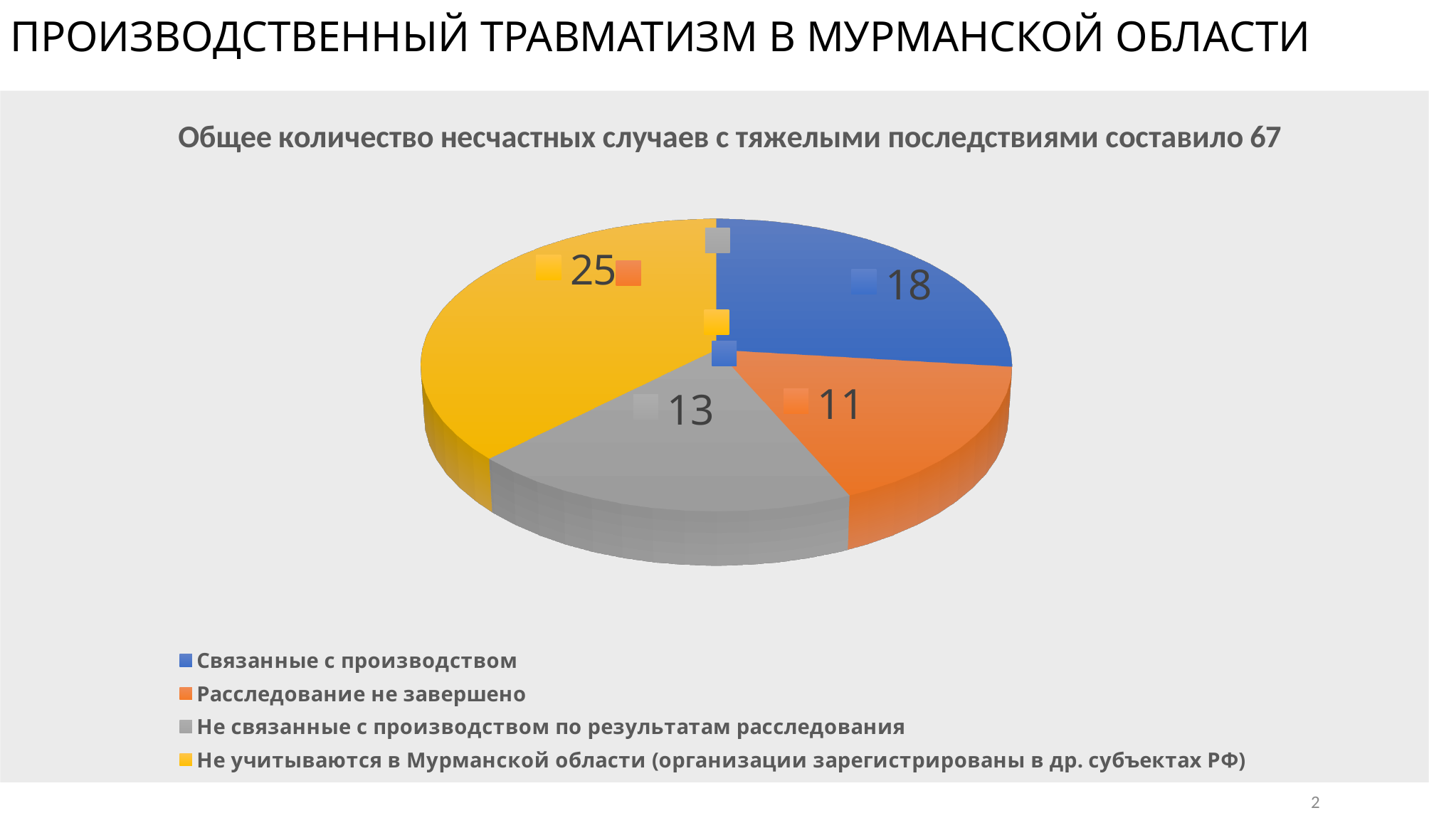
What is the difference between the values for 'Не учитываются в Мурманской области' and 'Связанные с производством'? 7 What colour is the slice for 'Расследование не завершено'? Orange What is the value for the slice 'Связанные с производством'? 18 Which category has the largest slice of the pie? Не учитываются в Мурманской области (организации зарегистрированы в др. субъектах РФ) What is the value for the slice 'Не связанные с производством по результатам расследования'? 13 What is the total of all slices in the pie chart? 67 What is the value for the slice 'Не учитываются в Мурманской области (организации зарегистрированы в др. субъектах РФ)'? 25 Which category has the smallest slice of the pie? Расследование не завершено What is the value for the slice 'Расследование не завершено'? 11 How many categories does the pie chart have? 4 What type of chart is shown on the slide? Pie chart Which is larger: 'Не связанные с производством по результатам расследования' or 'Расследование не завершено'? Не связанные с производством по результатам расследования